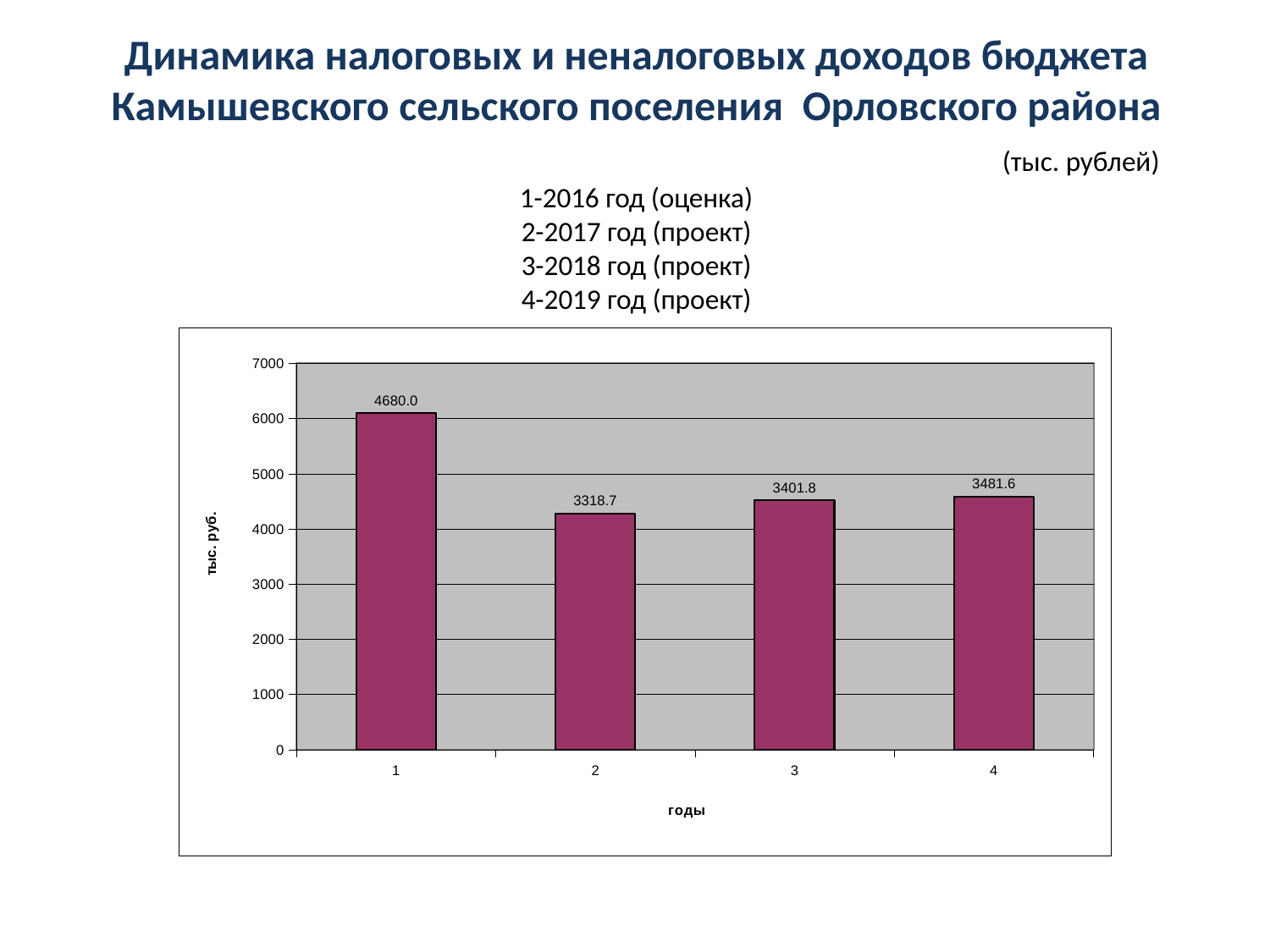
What kind of chart is shown on the slide? bar chart Which is larger, the value for category 3 or category 4? category 4 Which category has the lowest value? 2 What is the value for category 1 (2016 год, оценка)? 4680.0 What is the difference between the values for category 4 and category 3? 79.8 What is the label of the vertical axis? тыс. руб. What is the difference between the values for category 1 and category 2? 1361.3 Which category has the highest value? 1 What is the value for category 4 (2019 год, проект)? 3481.6 How many bars are shown in the chart? 4 What is the value for category 3 (2018 год, проект)? 3401.8 What is the value for category 2 (2017 год, проект)? 3318.7